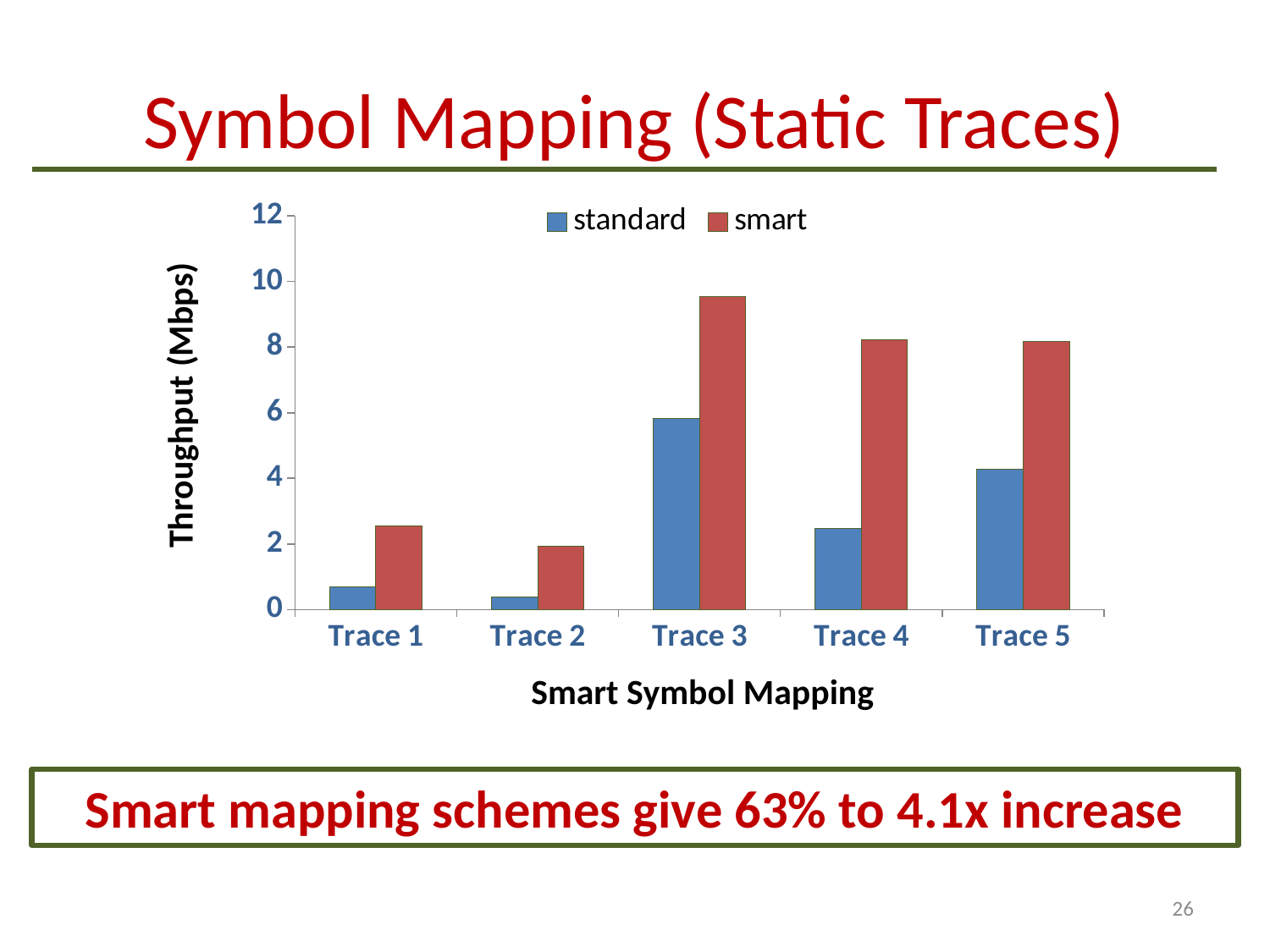
Is the smart throughput for Trace 3 greater or less than 8 Mbps? greater What is the label of the y axis? Throughput (Mbps) Which trace has the highest standard throughput? Trace 3 What kind of chart is shown on the slide? bar chart Which trace has the lowest standard throughput? Trace 2 Is the smart throughput for Trace 4 greater or less than 6 Mbps? greater Which trace has the highest smart throughput? Trace 3 How many series does the legend list? 2 Which trace has the lowest smart throughput? Trace 2 Which is larger, the standard throughput for Trace 3 or for Trace 5? Trace 3 How many traces are shown on the x axis? 5 Is the standard throughput for Trace 1 greater or less than 2 Mbps? less